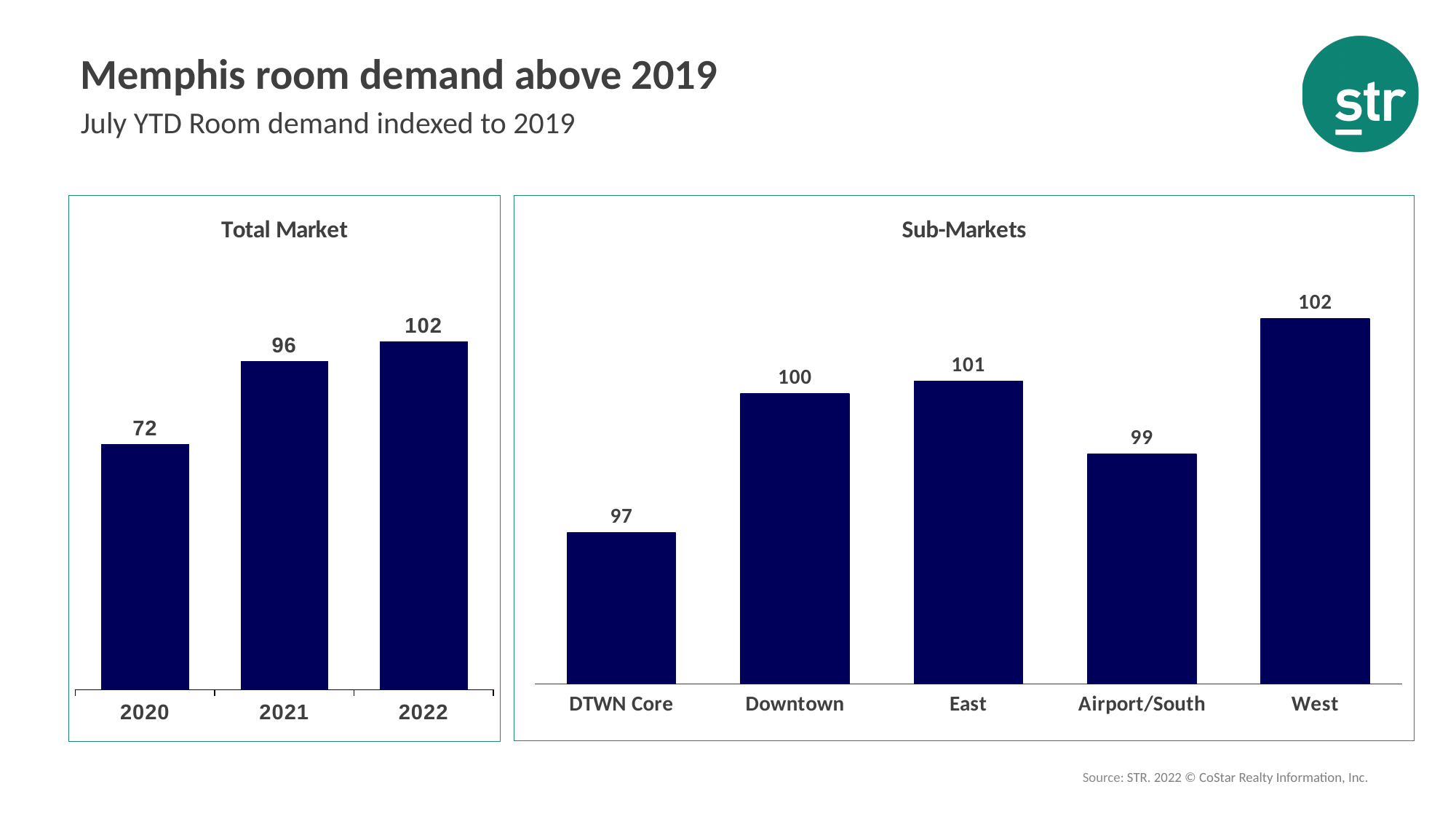
In the Sub-Markets chart, what is the value for Airport/South? 99 In the Sub-Markets chart, which sub-market has the lowest value? DTWN Core In the Total Market chart, which year has the lowest value? 2020 In the Sub-Markets chart, which sub-market has the highest value? West In the Total Market chart, what is the value for 2022? 102 In the Total Market chart, what is the difference between the 2022 and 2021 values? 6 In the Sub-Markets chart, what is the difference between the West and DTWN Core values? 5 What kind of chart is the Sub-Markets chart? bar chart In the Total Market chart, do the values rise or fall from 2020 to 2022? rise In the Total Market chart, what is the value for 2020? 72 In the Sub-Markets chart, what is the value for DTWN Core? 97 In the Total Market chart, how many years are shown? 3